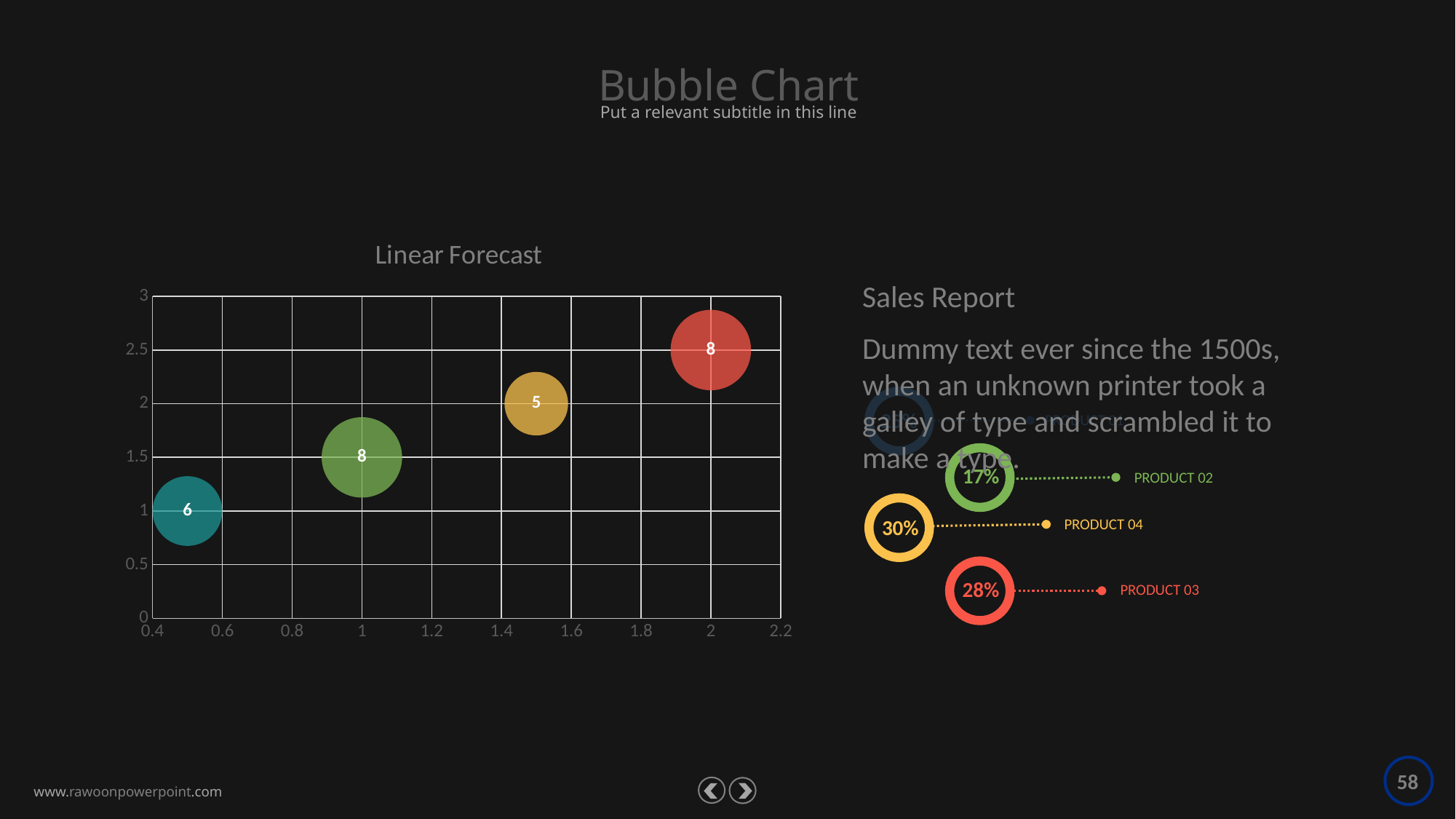
In the 'Linear Forecast' chart, do the bubbles rise or fall in y-value as the x-axis value increases? rise In the 'Linear Forecast' chart, at what y-axis value is the red bubble centred? 2.5 In the 'Linear Forecast' chart, what value is printed on the teal bubble? 6 In the 'Linear Forecast' chart, what is the difference between the value printed on the green bubble and the value printed on the gold bubble? 3 What type of chart is the 'Linear Forecast' chart? bubble chart How many bubbles are plotted in the 'Linear Forecast' chart? 4 In the 'Linear Forecast' chart, what value is printed on the gold bubble? 5 In the 'Linear Forecast' chart, which bubble has the smallest printed value? the gold bubble (5) What is the title of the chart on the left of the slide? Linear Forecast In the 'Linear Forecast' chart, what value is printed on the red bubble? 8 In the 'Linear Forecast' chart, is the y-axis position of the gold bubble greater or less than 1.5? greater In the 'Linear Forecast' chart, which has the larger printed value, the teal bubble or the gold bubble? the teal bubble